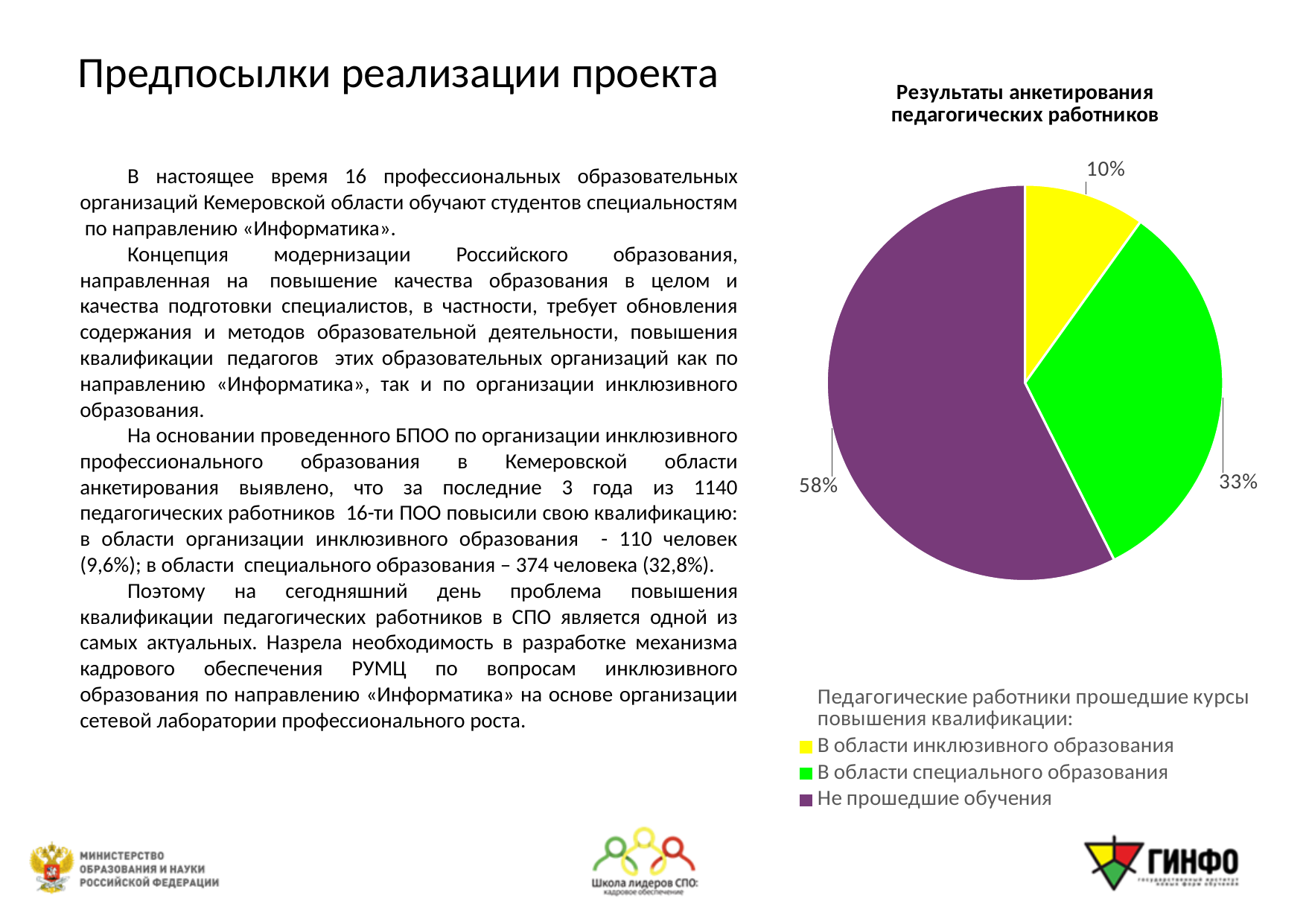
What is the difference in percentage points between 'Не прошедшие обучения' and 'В области специального образования'? 25 What share of the pie is labelled 'В области инклюзивного образования'? 10% What kind of chart is shown on the slide? pie chart How many slices does the pie chart have? 3 What is the chart's title? Результаты анкетирования педагогических работников What colour is the slice for 'Не прошедшие обучения'? purple Which is larger: the slice for 'В области специального образования' or the slice for 'В области инклюзивного образования'? В области специального образования What share of the pie is labelled 'В области специального образования'? 33% Which category has the smallest slice of the pie? В области инклюзивного образования What is the difference in percentage points between 'В области специального образования' and 'В области инклюзивного образования'? 23 What share of the pie is labelled 'Не прошедшие обучения'? 58% Which category has the largest slice of the pie? Не прошедшие обучения